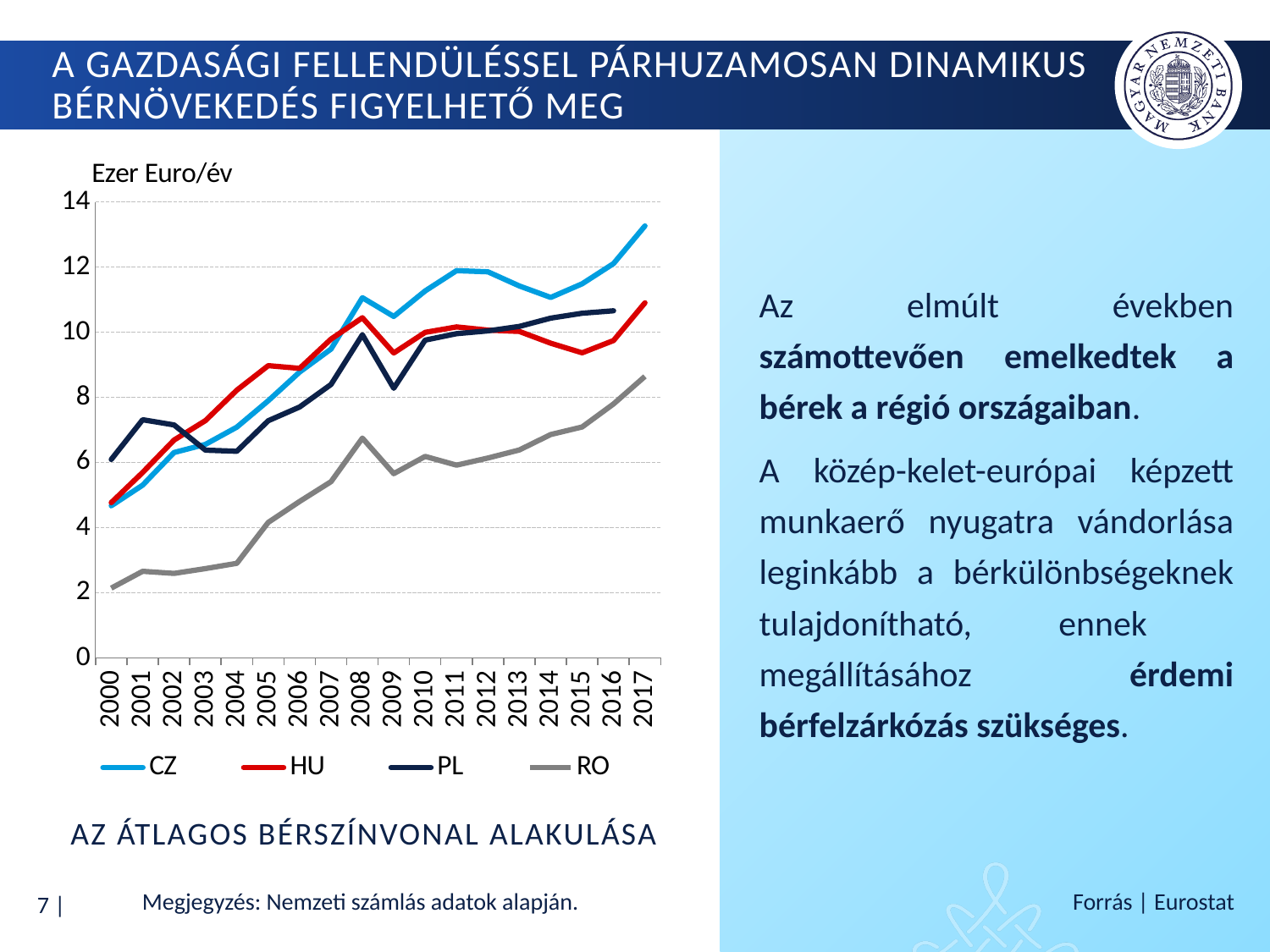
How many series does the legend list? 4 Which country has the highest value in 2017? CZ Which country has the lowest value in 2017? RO Does the RO series generally rise or fall from 2000 to 2017? rise In 2000, which is larger, the value for PL or the value for CZ? PL Which country has the lowest value in 2000? RO Is the value for CZ in 2000 greater or less than 6? less Is the value for RO in 2000 greater or less than 4? less What kind of chart is shown on the slide? line chart What unit is shown above the y axis of the chart? Ezer Euro/év Is the value for CZ in 2017 greater or less than 12? greater How many years are shown along the x axis? 18